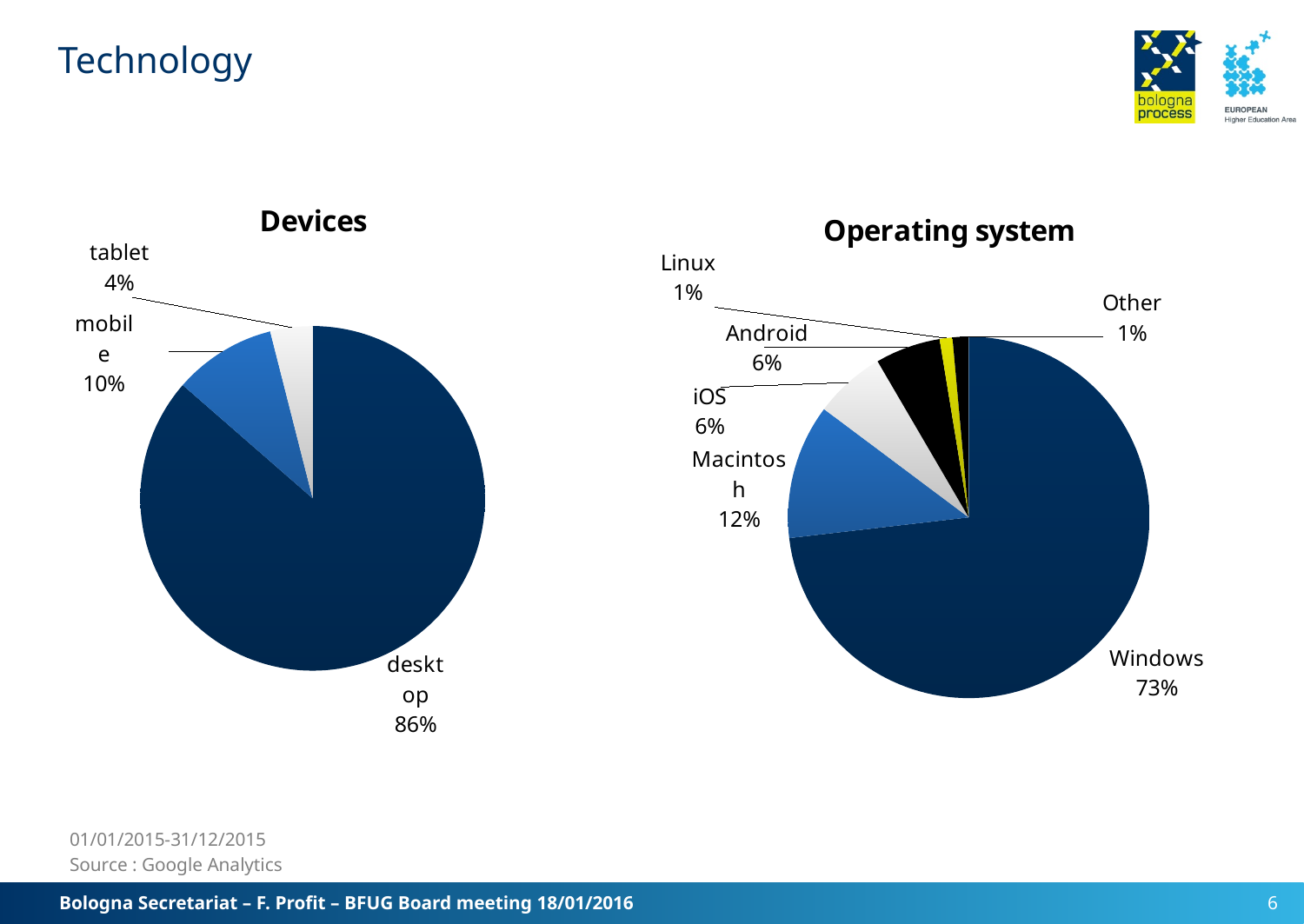
In the Operating system chart, what is the difference between the Windows and Macintosh shares? 61% In the Operating system chart, what share is shown for Windows? 73% What type of chart is used for the Devices chart? pie chart In the Operating system chart, which operating system has the largest slice? Windows In the Devices chart, what percentage is shown for mobile? 10% In the Operating system chart, which is larger, Macintosh or Android? Macintosh In the Devices chart, what share of the pie is desktop? 86% In the Devices chart, what is the difference between the desktop and mobile shares? 76% In the Operating system chart, how many categories are shown? 6 In the Operating system chart, what percentage is Macintosh? 12% In the Devices chart, how many slices does the pie have? 3 In the Devices chart, which category has the smallest slice? tablet